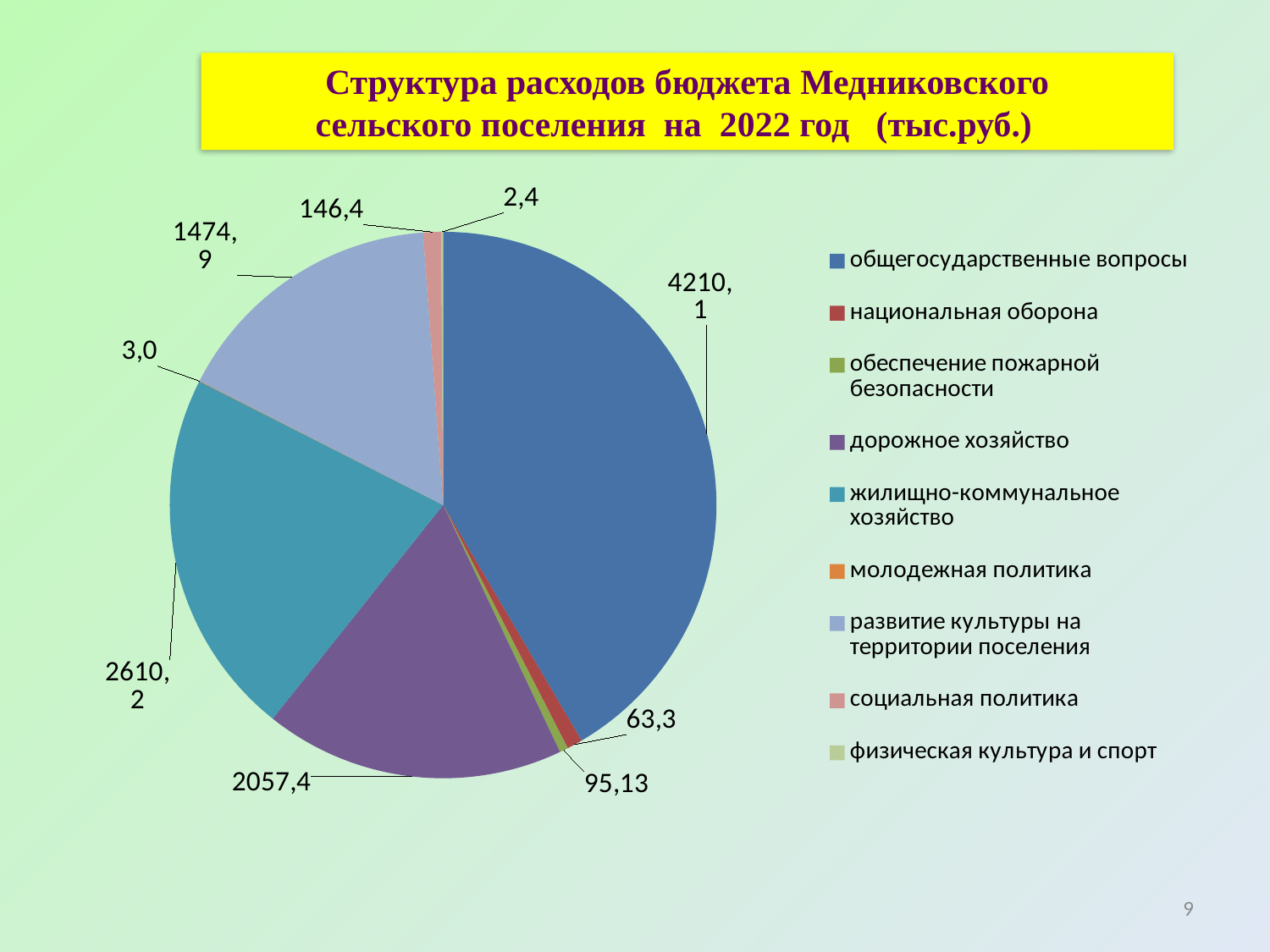
Which is larger, жилищно-коммунальное хозяйство or дорожное хозяйство? жилищно-коммунальное хозяйство How many categories does the legend list? 9 What is the value for общегосударственные вопросы? 4210,1 What is the value for развитие культуры на территории поселения? 1474,9 What type of chart is shown on the slide? pie chart What is the value for социальная политика? 146,4 What is the difference between жилищно-коммунальное хозяйство and дорожное хозяйство? 552,8 What is the value for жилищно-коммунальное хозяйство? 2610,2 Which category has the largest slice of the pie? общегосударственные вопросы What is the value for дорожное хозяйство? 2057,4 What is the title of the chart? Структура расходов бюджета Медниковского сельского поселения на 2022 год (тыс.руб.) What is the difference between общегосударственные вопросы and жилищно-коммунальное хозяйство? 1599,9